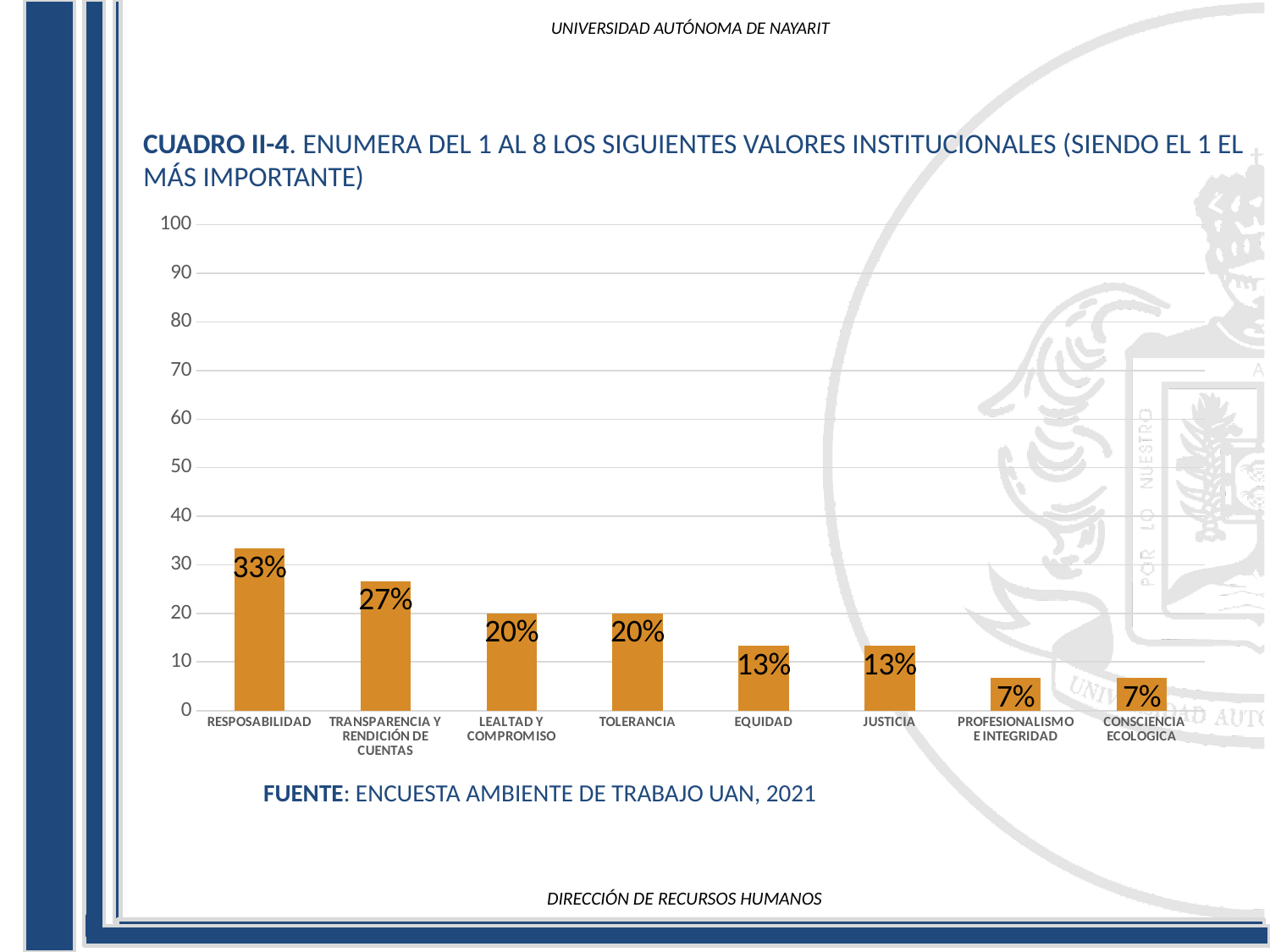
How many categories are shown on the x axis? 8 What is the value for EQUIDAD? 13% What kind of chart is shown on the slide? bar chart Which category has the highest value? RESPOSABILIDAD What is the value for CONSCIENCIA ECOLOGICA? 7% Is the value for TRANSPARENCIA Y RENDICIÓN DE CUENTAS greater or less than 30? less What is the value for RESPOSABILIDAD? 33% What is the difference between the values for TOLERANCIA and JUSTICIA? 7% What is the value for TRANSPARENCIA Y RENDICIÓN DE CUENTAS? 27% Do the values rise or fall from left to right along the x axis? fall Which is larger, the value for LEALTAD Y COMPROMISO or the value for PROFESIONALISMO E INTEGRIDAD? LEALTAD Y COMPROMISO What is the difference between the values for RESPOSABILIDAD and TRANSPARENCIA Y RENDICIÓN DE CUENTAS? 6%